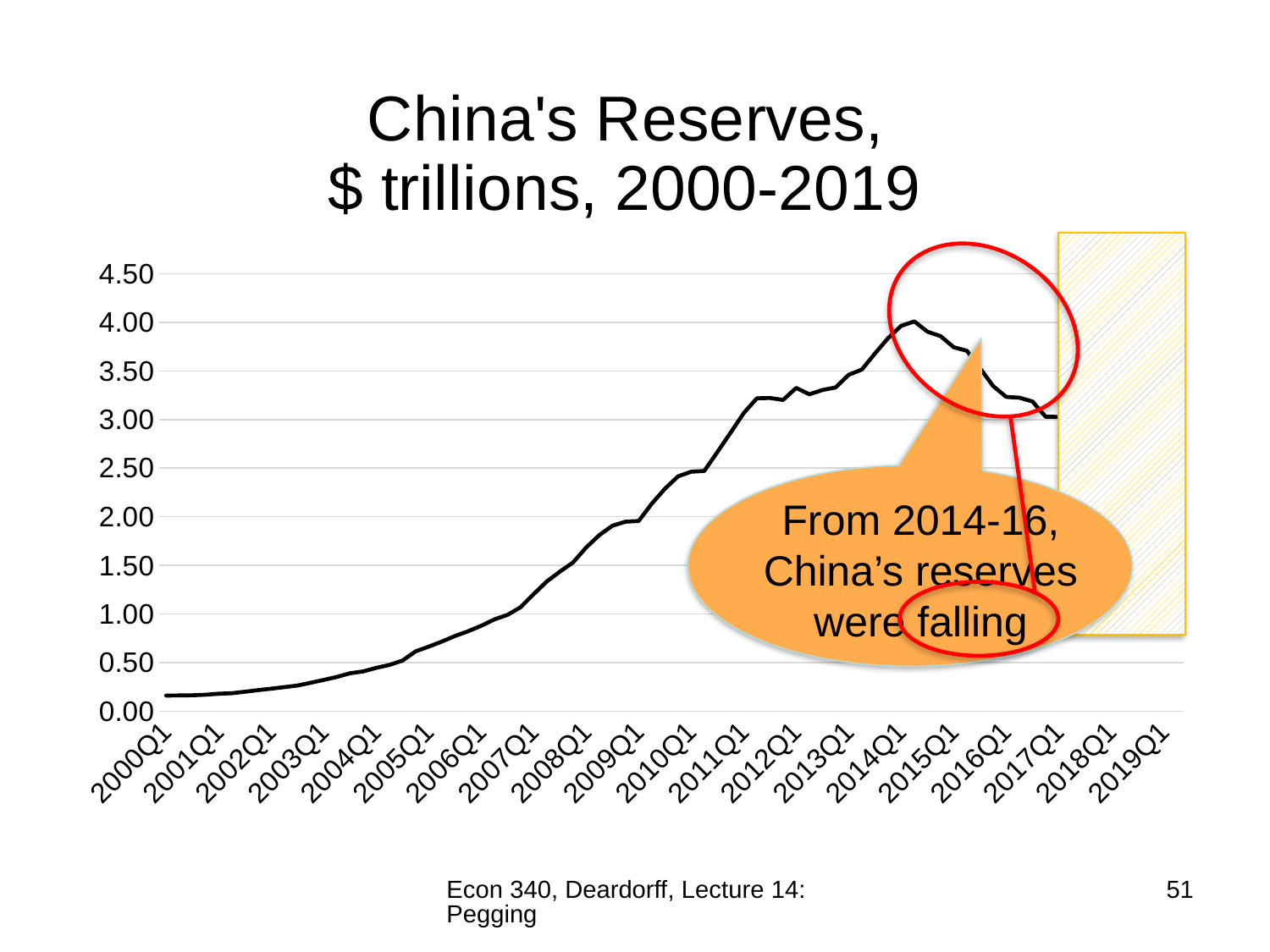
Is the value for 2000Q1 greater or less than 0.50? less Which is larger, the value for 2014Q1 or the value for 2017Q1? 2014Q1 Is the value for 2012Q1 greater or less than 3.00? greater What is the title of the chart? China's Reserves, $ trillions, 2000-2019 Is the value for 2014Q1 greater or less than 3.50? greater According to the annotation, what happened to China's reserves from 2014-16? they were falling What unit are China's reserves measured in on the chart? $ trillions Do China's reserves rise or fall between 2000Q1 and 2014Q1? rise What kind of chart is shown on the slide? line chart How many quarter labels are shown on the x axis? 20